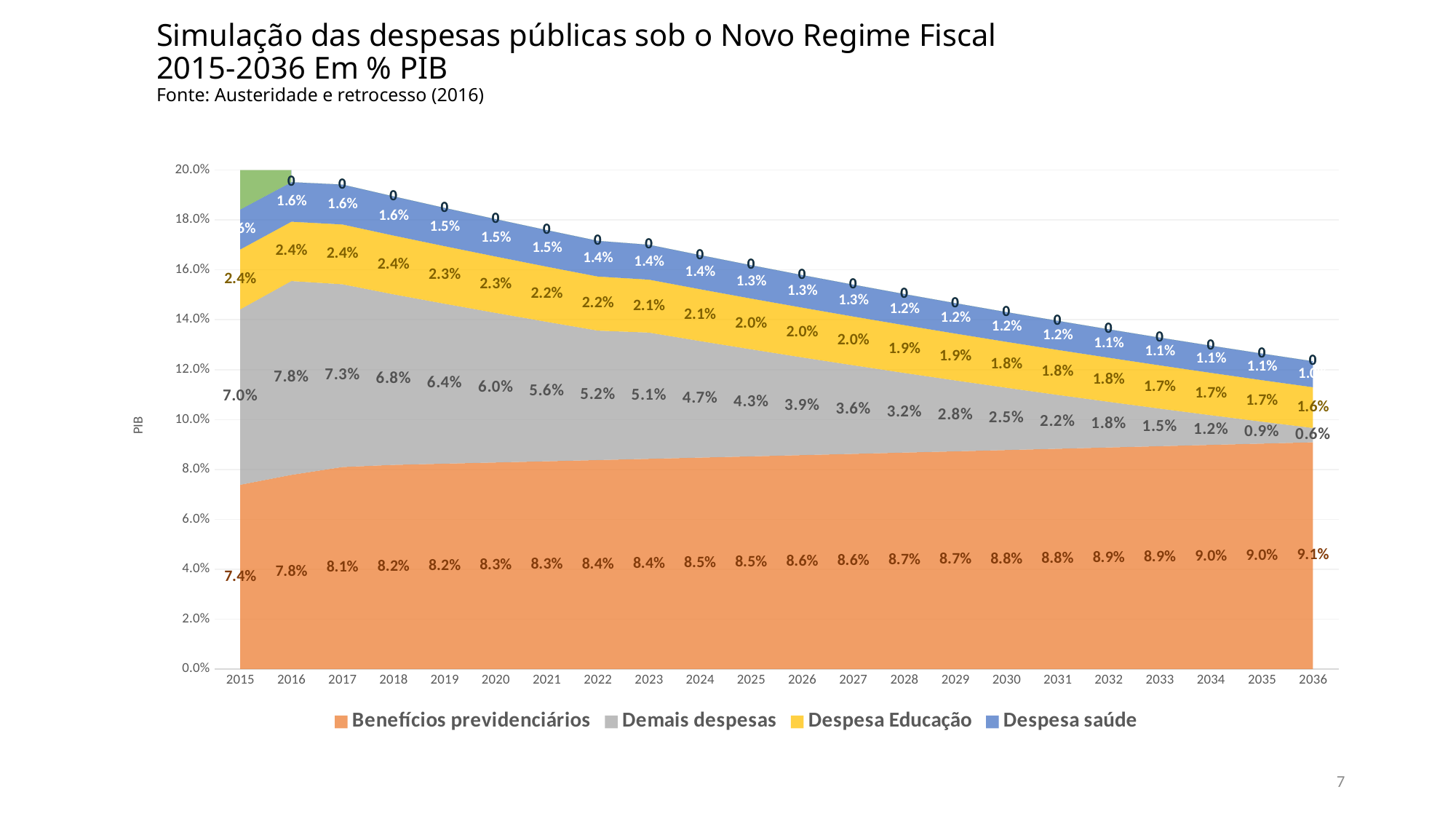
What is the value for Benefícios previdenciários in 2036? 9.1% In which year is Demais despesas lowest? 2036 How many series does the legend list? 4 Do the values for Demais despesas rise or fall from 2016 to 2036? Fall What is the value for Demais despesas in 2020? 6.0% What is the value for Despesa saúde in 2030? 1.2% What is the value for Despesa Educação in 2025? 2.0% What kind of chart is shown on the slide? Stacked area chart How many years are shown on the x axis? 22 What is the difference between Demais despesas in 2016 and in 2036? 7.2 percentage points In 2015, which is larger: Benefícios previdenciários or Demais despesas? Benefícios previdenciários In which year is Demais despesas highest? 2016